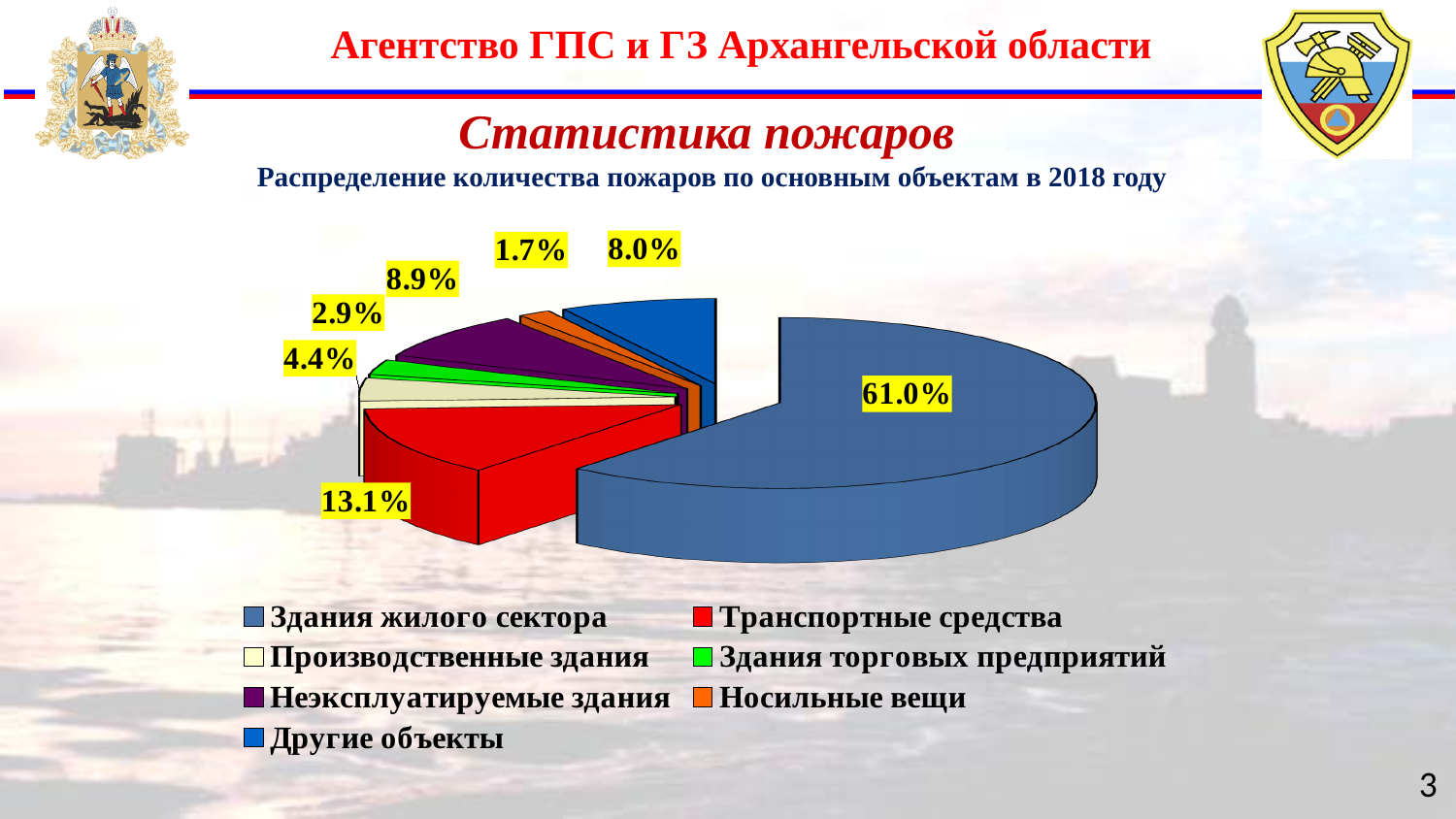
What share of fires is attributed to Транспортные средства? 13.1% Which category has the smallest share of fires? Носильные вещи What share of fires in 2018 is attributed to Здания жилого сектора? 61.0% Which has a larger share: Здания торговых предприятий or Производственные здания? Производственные здания What share of fires is attributed to Носильные вещи? 1.7% What is the difference between the shares for Транспортные средства and Неэксплуатируемые здания? 4.2% Which category has the largest share of fires? Здания жилого сектора How many categories does the legend list? 7 What share of fires is attributed to Неэксплуатируемые здания? 8.9% What year does the chart's subtitle say the fire distribution refers to? 2018 What share of fires is attributed to Производственные здания? 4.4% What kind of chart is shown on the slide? pie chart